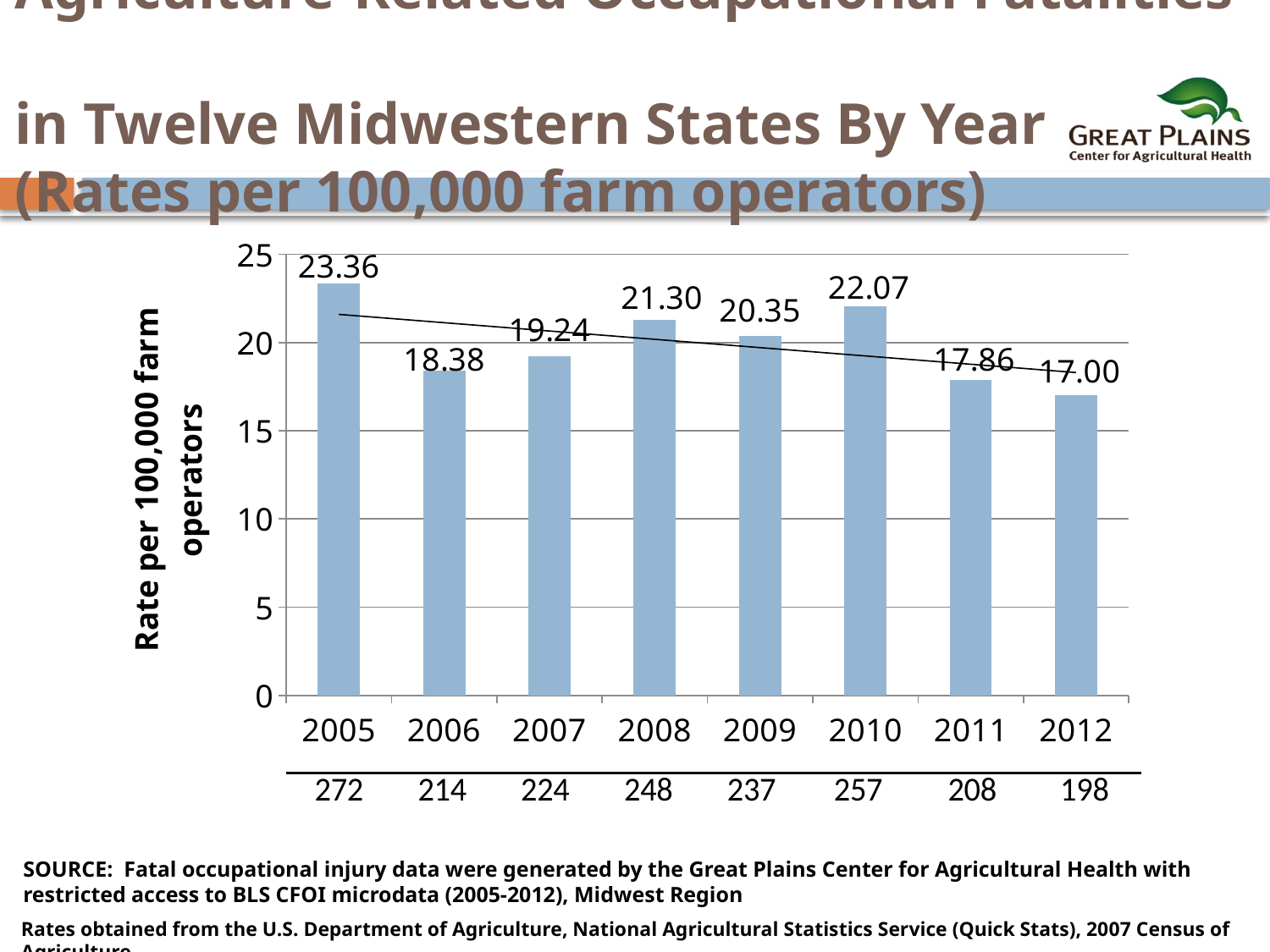
Which year has a higher rate, 2008 or 2009? 2008 What is the rate per 100,000 farm operators for 2012? 17.00 What is the rate per 100,000 farm operators for 2010? 22.07 Which year has the highest rate per 100,000 farm operators? 2005 What is the rate per 100,000 farm operators for 2005? 23.36 Is the rate for 2007 greater or less than 20? less What is the overall trend of the rates from 2005 to 2012? falling What kind of chart is shown on the slide? bar chart How many years are shown on the x axis of the chart? 8 What is the difference between the rates for 2005 and 2006? 4.98 What is the difference between the rates for 2010 and 2011? 4.21 Which year has the lowest rate per 100,000 farm operators? 2012